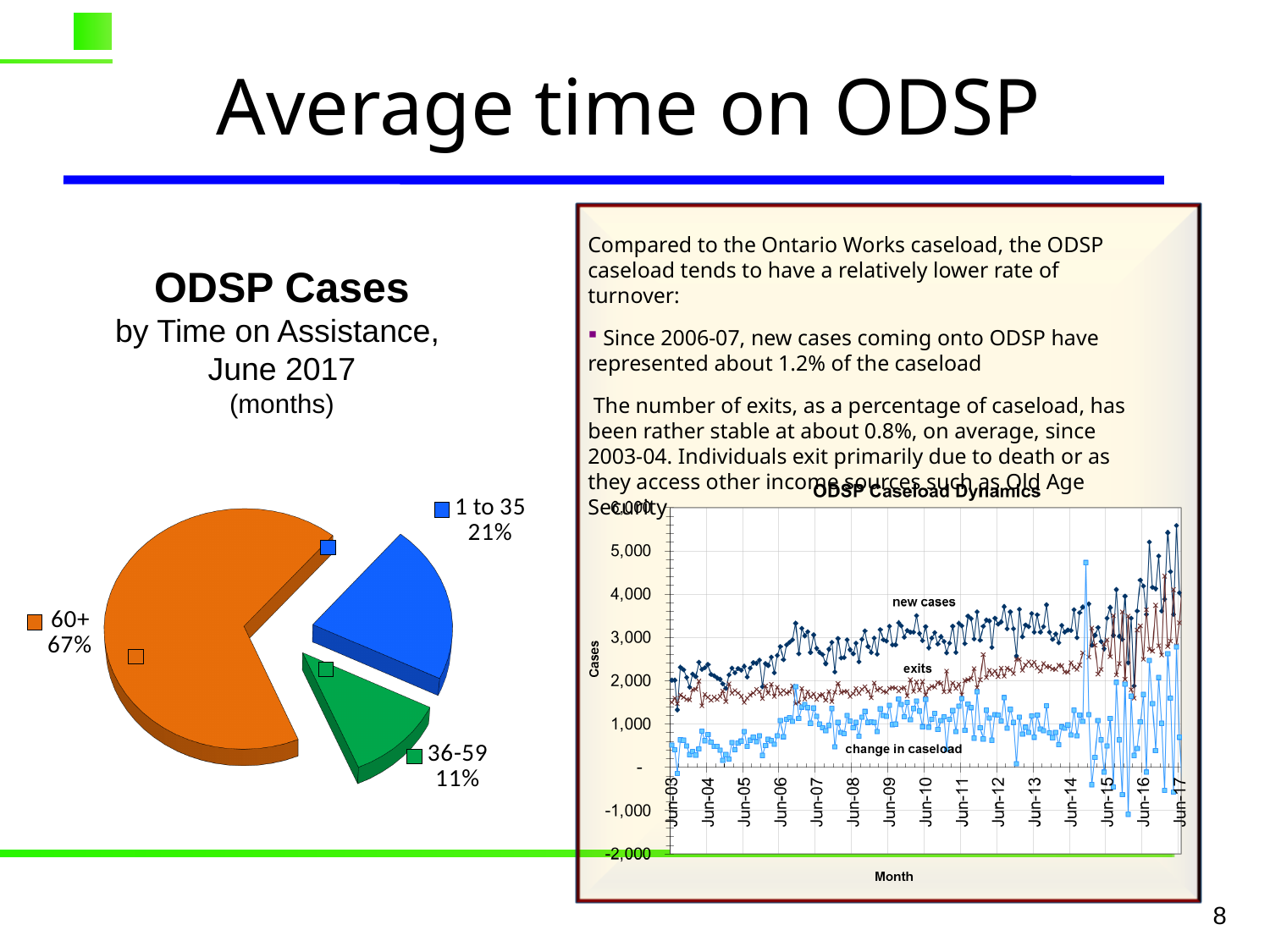
On the ODSP Cases pie chart, how many percentage points larger is the 60+ share than the 1 to 35 share? 46 On the ODSP Cases pie chart, which time-on-assistance category has the largest share? 60+ On the ODSP Caseload Dynamics chart, what is the label of the x axis? Month On the ODSP Cases pie chart, how many categories are shown? 3 What kind of chart is the ODSP Cases chart on the left of the slide? Pie chart On the ODSP Cases pie chart, what share of cases have been on assistance for 1 to 35 months? 21% On the ODSP Cases pie chart, which time-on-assistance category has the smallest share? 36-59 On the ODSP Cases pie chart, what share of cases have been on assistance for 36-59 months? 11% On the ODSP Cases pie chart, what share of cases have been on assistance for 60+ months? 67% On the ODSP Caseload Dynamics chart, how many series are plotted? 3 On the ODSP Caseload Dynamics chart, do the new cases values generally rise or fall from Jun-03 to Jun-17? Rise What kind of chart is the ODSP Caseload Dynamics chart on the right of the slide? Line chart